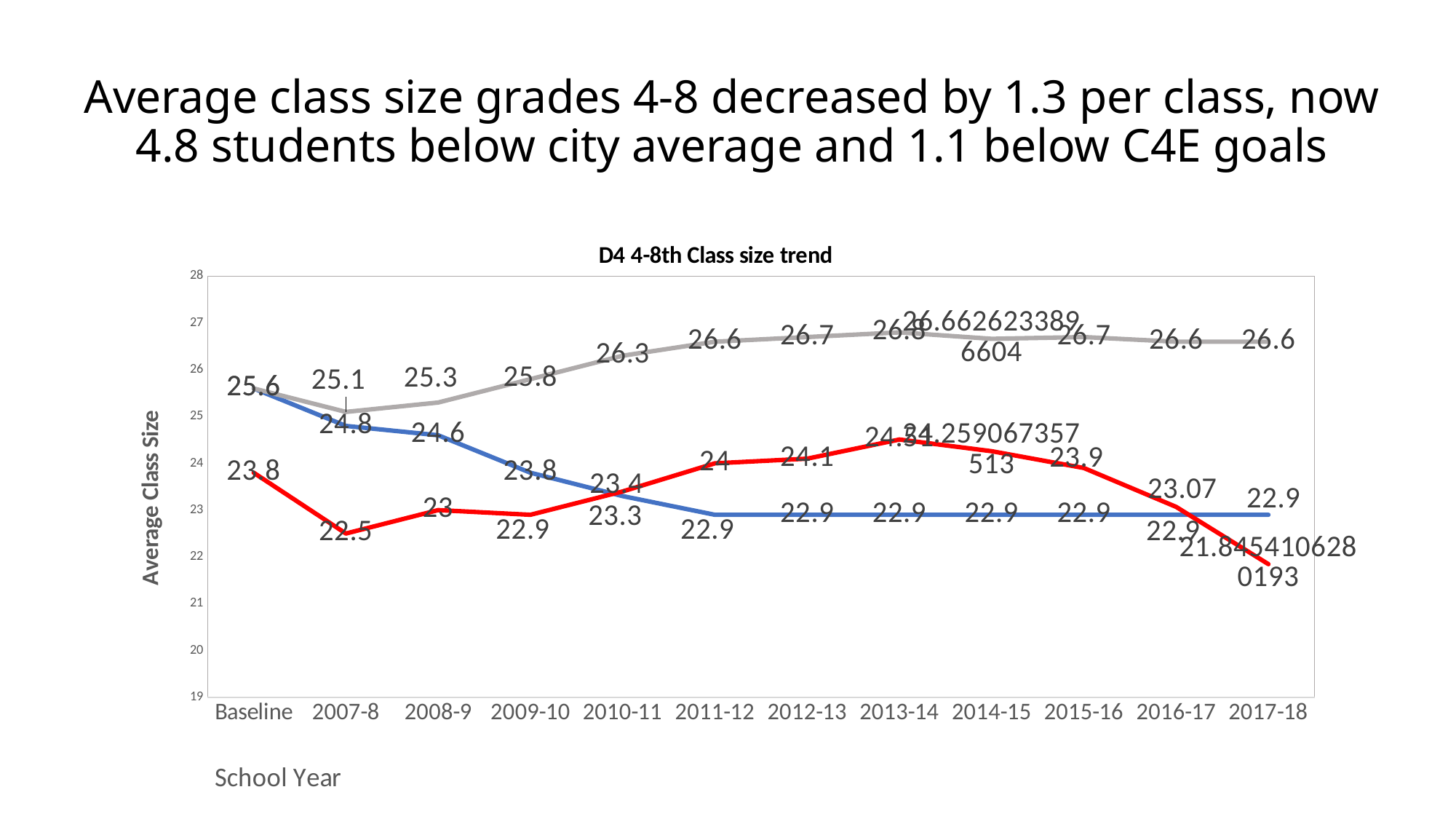
What is the value of the gray line for 2017-18? 26.6 Is the value of the red line for 2017-18 greater or less than 22? less What type of chart is shown on the slide? line chart How many school years (categories) are shown on the x axis? 12 What is the difference between the gray line and the blue line in 2017-18? 3.7 Which line has the highest value in 2017-18? the gray line What is the value of the blue line for 2009-10? 23.8 What is the value of the red line for 2007-8? 22.5 What is the value of the red line for 2016-17? 23.07 Does the gray line generally rise or fall from Baseline to 2017-18? rise What is the title of the chart? D4 4-8th Class size trend What is the value of the gray line for 2011-12? 26.6